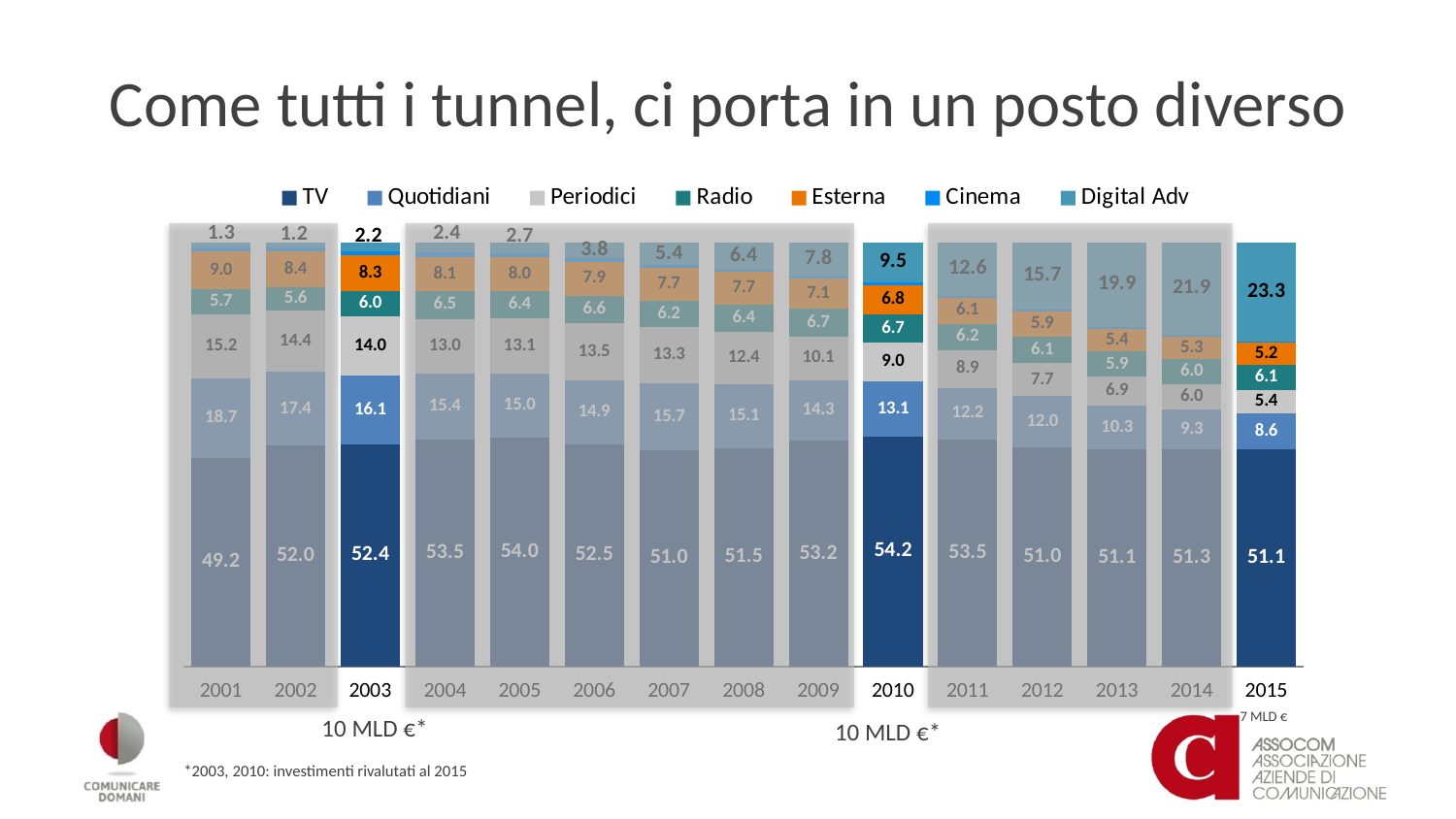
Do the Quotidiani values rise or fall from 2001 to 2015? Fall What is the value for Quotidiani in 2003? 16.1 What kind of chart is shown on the slide? Stacked bar chart How many years are shown along the x axis? 15 Which year has the larger Esterna value, 2003 or 2015? 2003 In which year is the Digital Adv value highest? 2015 Which series is listed first in the legend? TV What is the value for Digital Adv in 2010? 9.5 How many series does the legend list? 7 What is the value for TV in 2015? 51.1 What is the difference between the Digital Adv value in 2015 and in 2003? 21.1 What is the value for Periodici in 2010? 9.0